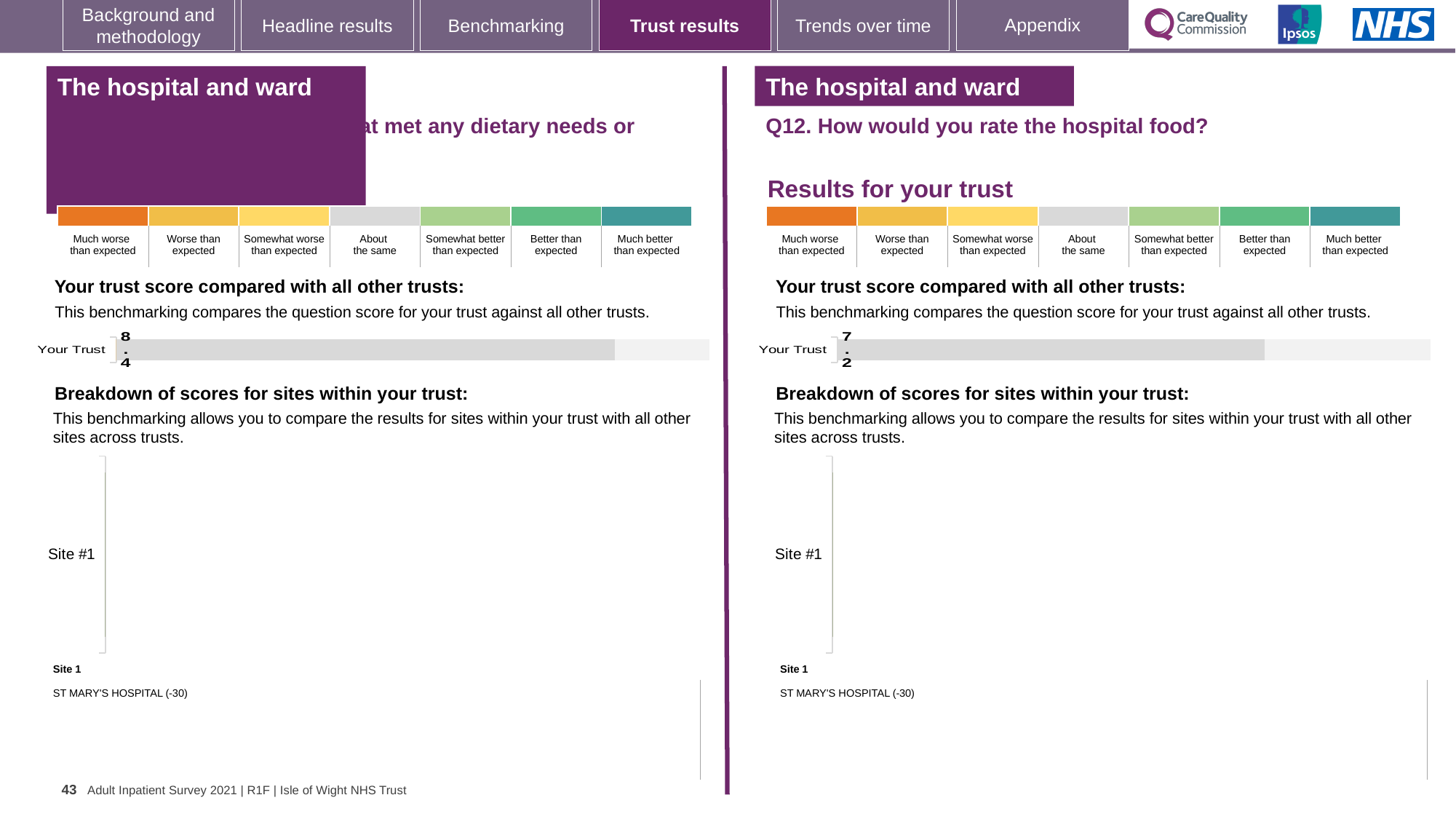
On the right chart (Q12), what is the label of the leftmost (orange) band of the benchmarking scale? Much worse than expected What is the difference between the Your Trust score on the left chart and the Your Trust score on the right chart (Q12)? 1.2 On the left chart, what is the score shown for Your Trust? 8.4 On the right chart (Q12), how many categories are plotted in the 'Your trust score compared with all other trusts' chart? 1 What kind of chart is used to show the Your Trust score on the right chart (Q12)? bar chart On the right chart (Q12), is the Your Trust score greater or less than 7? greater Which chart shows the higher Your Trust score, the left chart or the right chart (Q12)? the left chart On the right chart (Q12. How would you rate the hospital food?), what is the score shown for Your Trust? 7.2 On the left chart, is the Your Trust score greater or less than 8? greater On the right chart (Q12), how many colour bands are shown in the benchmarking scale above the chart? 7